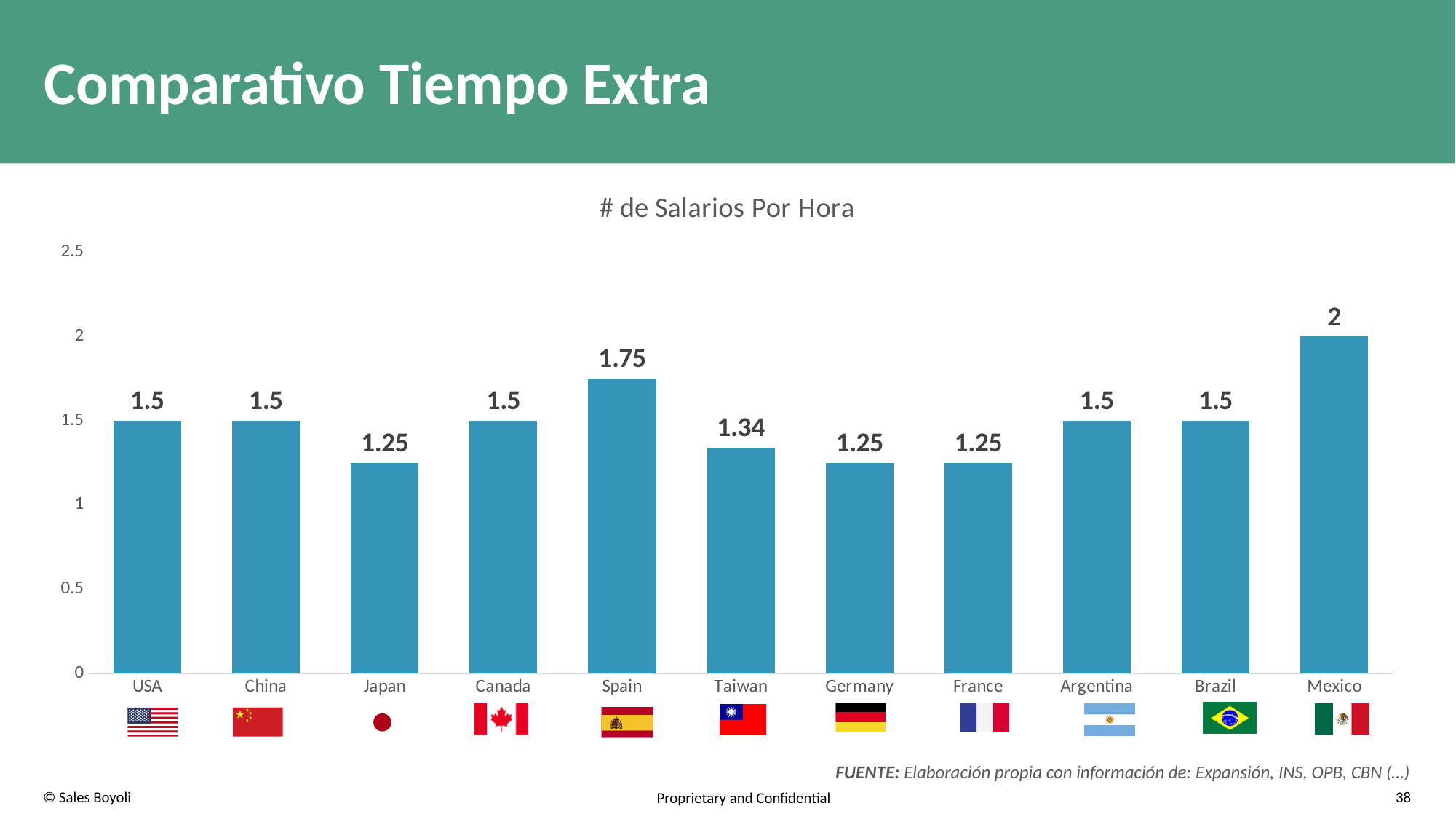
What is the difference between the values for Taiwan and Germany? 0.09 What is the title of the chart? # de Salarios Por Hora Which country has the highest value? Mexico What is the value for Spain? 1.75 Which is larger, the value for Taiwan or the value for France? Taiwan How many countries are shown on the x axis? 11 Which is larger, the value for Spain or the value for Canada? Spain What is the difference between the values for Mexico and Spain? 0.25 What is the value for Mexico? 2 What is the value for Taiwan? 1.34 How many countries have a value of 1.25? 3 What kind of chart is this? Bar chart